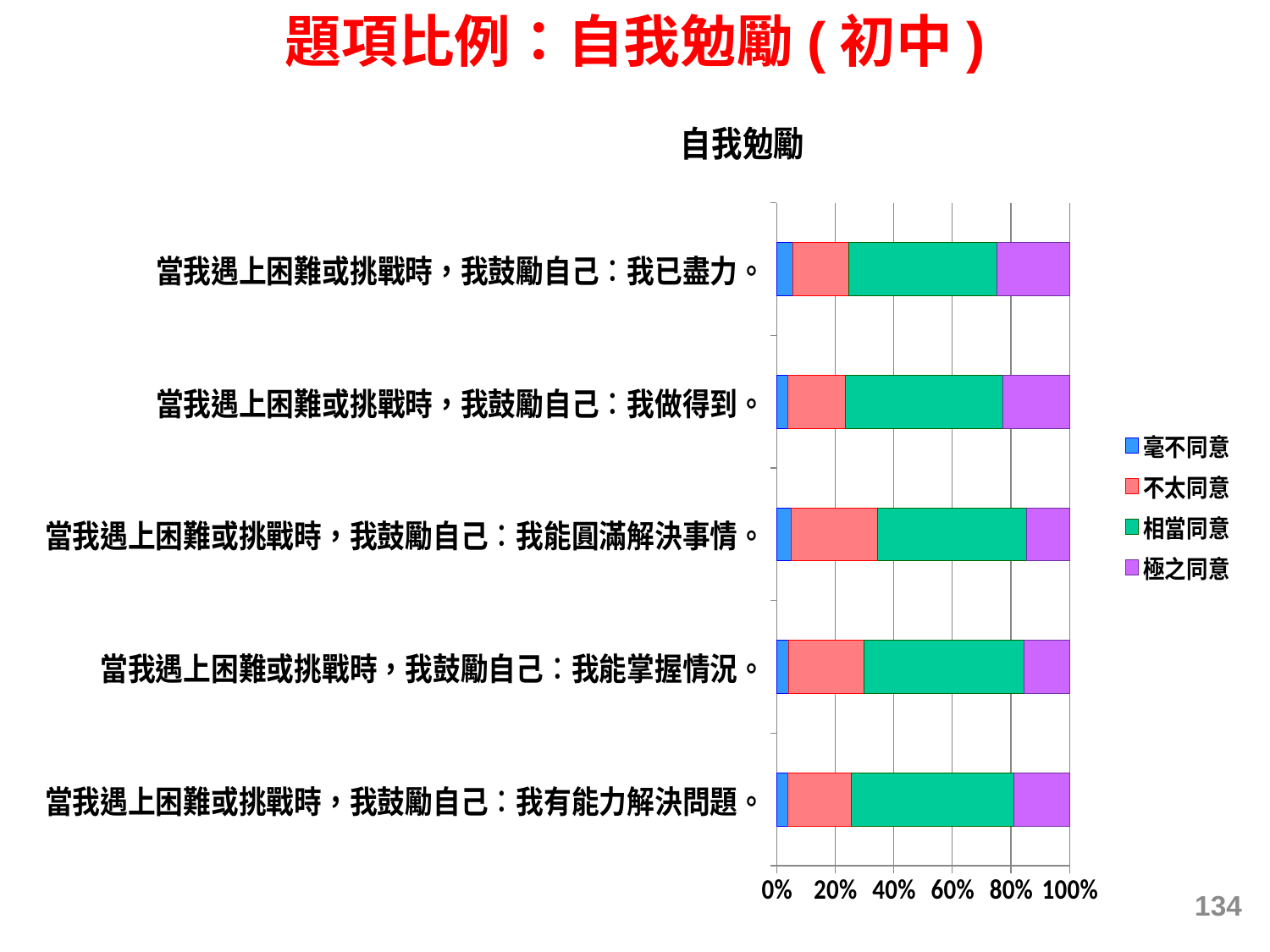
How many series does the legend list? 4 Which statement has the larger 極之同意 share: 「我已盡力」 or 「我能圓滿解決事情」? 我已盡力 Which legend entry is shown in purple? 極之同意 What is the title of the chart? 自我勉勵 What is the total of the stacked bar for 「當我遇上困難或挑戰時，我鼓勵自己：我已盡力。」? 100% Is the 相當同意 share for 「當我遇上困難或挑戰時，我鼓勵自己：我已盡力。」 greater or less than 40%? greater Which statement has the larger 不太同意 share: 「我已盡力」 or 「我能圓滿解決事情」? 我能圓滿解決事情 How many statements (categories) are plotted in the chart? 5 Is the 不太同意 share for 「當我遇上困難或挑戰時，我鼓勵自己：我能圓滿解決事情。」 greater or less than 20%? greater What is the highest value shown on the horizontal axis? 100% Is the 毫不同意 share for 「當我遇上困難或挑戰時，我鼓勵自己：我有能力解決問題。」 greater or less than 20%? less What kind of chart is shown on the slide? Stacked bar chart